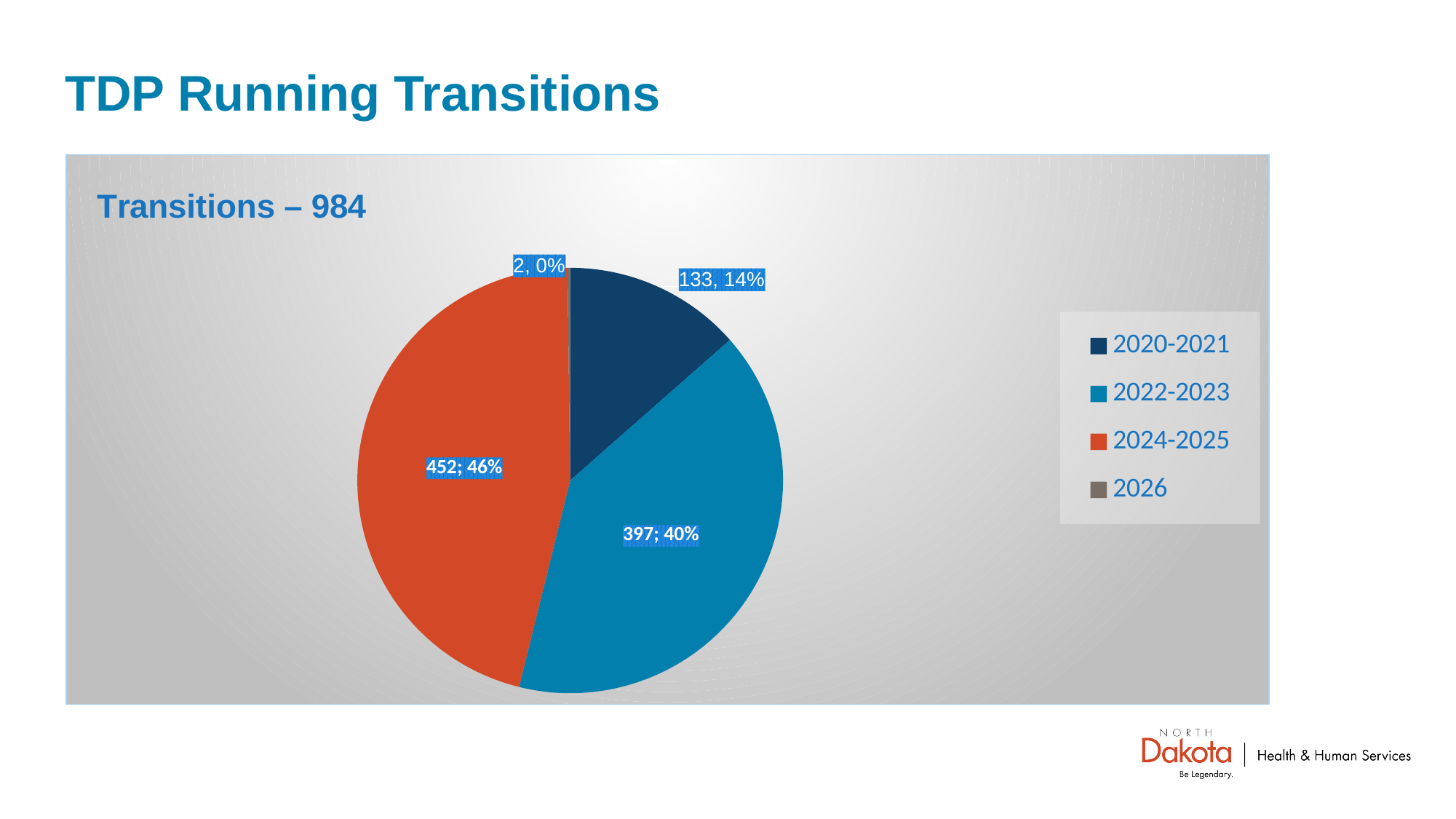
How many transitions are shown for 2020-2021? 133 What kind of chart is shown on the slide? pie chart What is the difference in transitions between 2024-2025 and 2022-2023? 55 How many transitions are shown for 2022-2023? 397 How many transitions are shown for 2026? 2 Which period has the smallest share of transitions? 2026 How many transitions are shown for 2024-2025? 452 Which has more transitions, 2020-2021 or 2022-2023? 2022-2023 What percentage of transitions does the 2020-2021 slice represent? 14% What percentage of transitions does the 2022-2023 slice represent? 40% Which period has the largest share of transitions? 2024-2025 How many categories does the legend list? 4